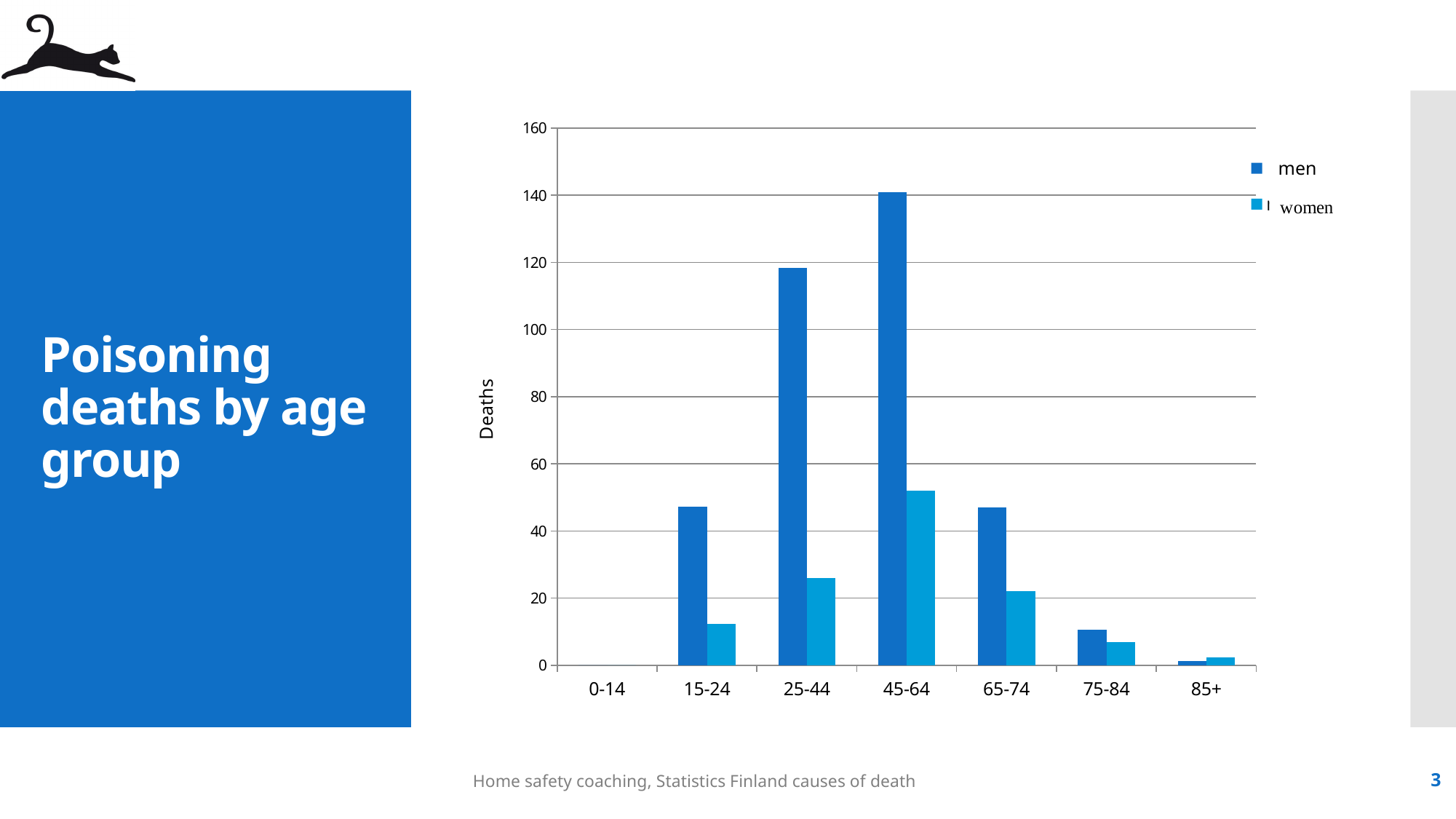
What is the label on the vertical axis? Deaths How many age groups are shown on the x axis? 7 What kind of chart is shown on the slide? bar chart Do the values for men rise or fall from the 45-64 age group to the 85+ age group? fall Is the value for men in the 75-84 age group greater or less than 20? less Which age group has the highest number of poisoning deaths for women? 45-64 In the 45-64 age group, which series has the larger value, men or women? men Is the value for men in the 25-44 age group greater or less than 100? greater Is the value for women in the 45-64 age group greater or less than 40? greater Which age group has the highest number of poisoning deaths for men? 45-64 How many series does the legend list? 2